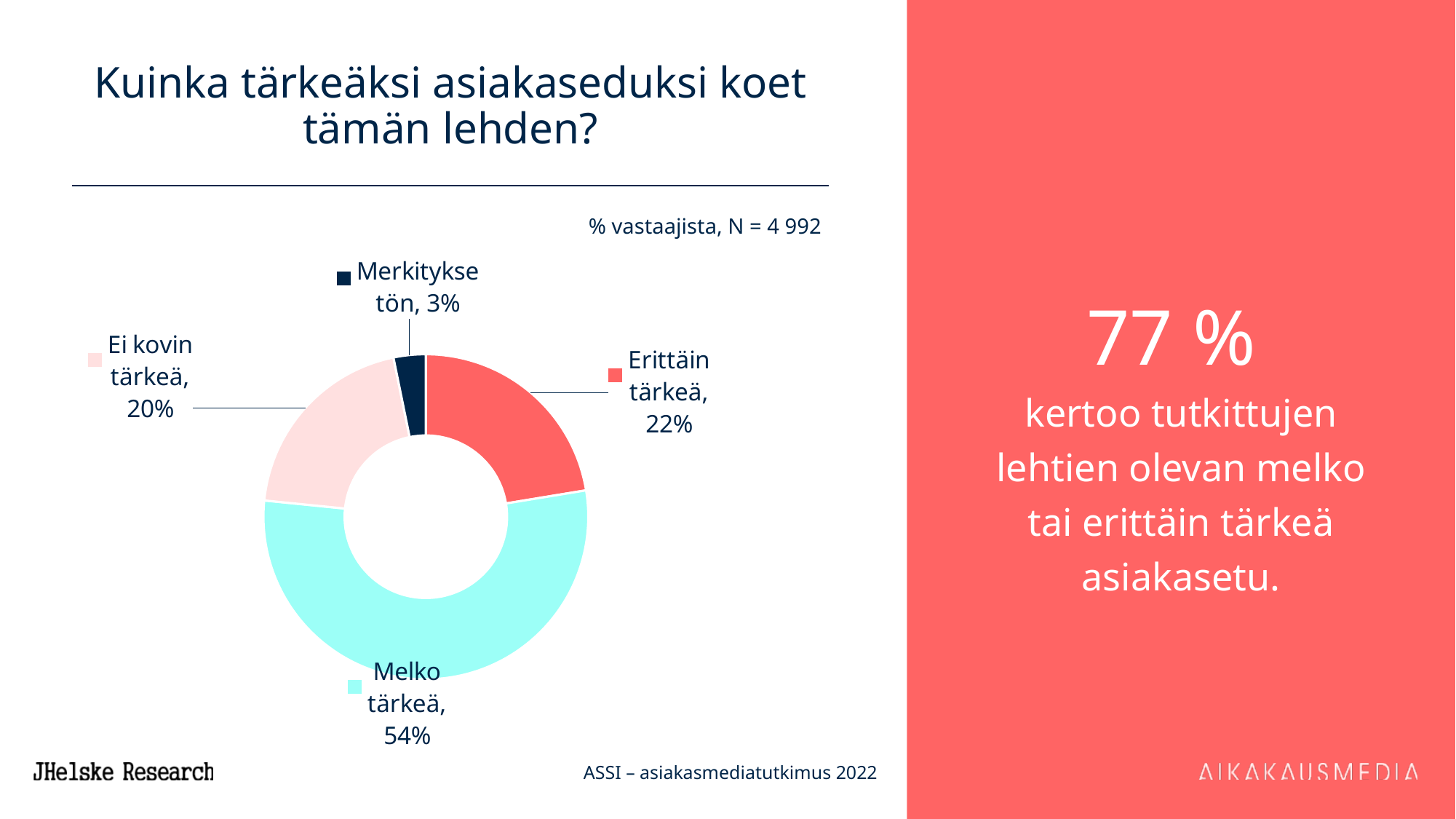
What is the number of respondents (N) stated on the slide? 4 992 What percentage of respondents answered "Melko tärkeä"? 54% What percentage of respondents answered "Ei kovin tärkeä"? 20% How many categories are shown in the chart? 4 What kind of chart is shown on the slide? Doughnut (pie) chart What percentage of respondents answered "Merkityksetön"? 3% Which category has the largest share of the chart? Melko tärkeä Which category has the smallest share of the chart? Merkityksetön What is the combined share of "Melko tärkeä" and "Erittäin tärkeä"? 77 % Which is larger, the share for "Erittäin tärkeä" or for "Ei kovin tärkeä"? Erittäin tärkeä What is the difference in percentage points between "Melko tärkeä" and "Erittäin tärkeä"? 32 What percentage of respondents answered "Erittäin tärkeä"? 22%